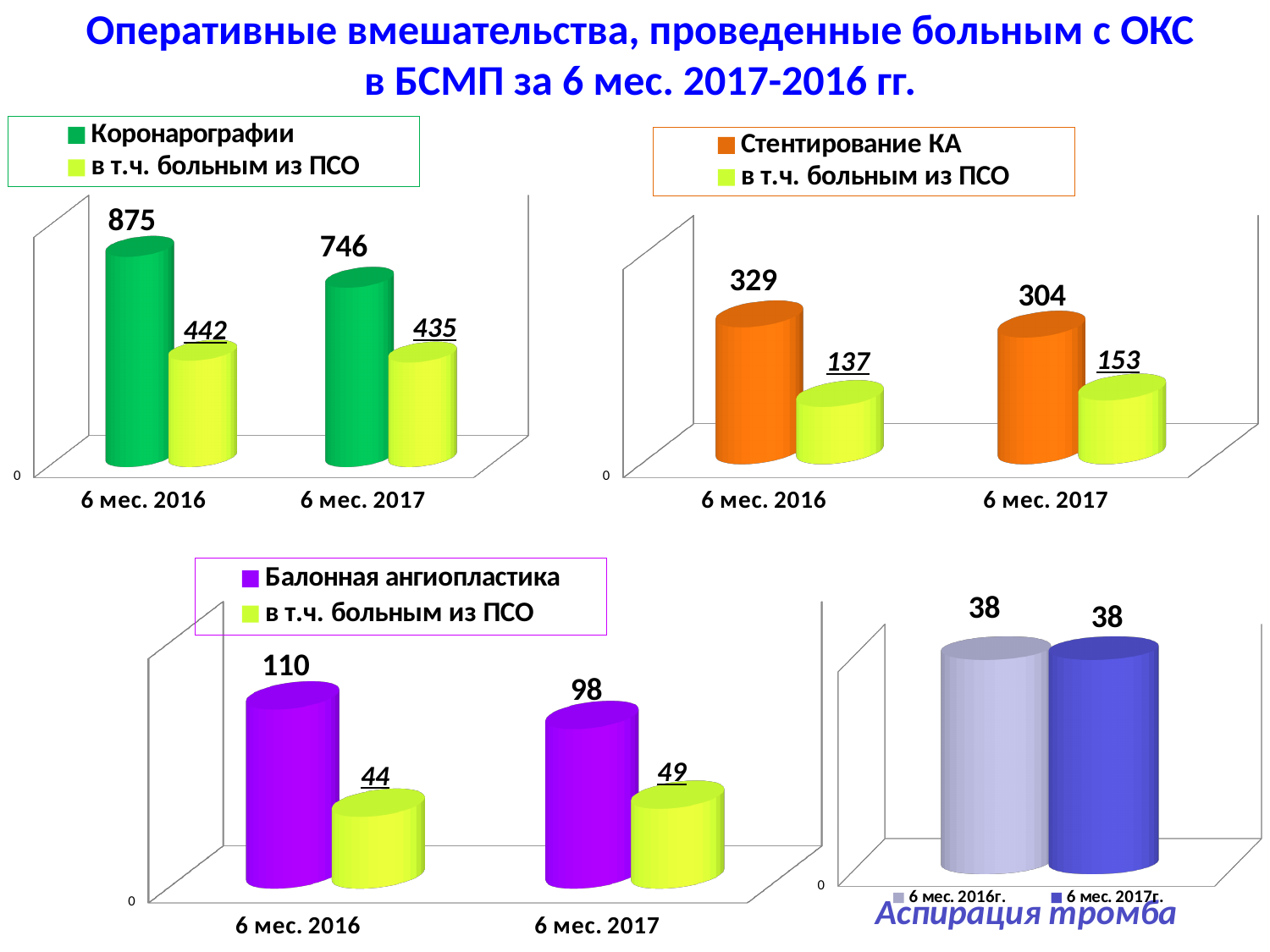
In the top-right chart (Стентирование КА), what is the difference between the в т.ч. больным из ПСО values for 6 мес. 2017 and 6 мес. 2016? 16 In the top-right chart (Стентирование КА), which period has the higher value for в т.ч. больным из ПСО, 6 мес. 2016 or 6 мес. 2017? 6 мес. 2017 In the bottom-right chart (Аспирация тромба), what is the value for 6 мес. 2017г.? 38 In the top-left chart (Коронарографии), what is the value for Коронарографии in 6 мес. 2016? 875 In the top-left chart (Коронарографии), what is the value for в т.ч. больным из ПСО in 6 мес. 2017? 435 What kind of chart is the bottom-right chart (Аспирация тромба)? bar chart In the bottom-left chart (Балонная ангиопластика), what is the value for Балонная ангиопластика in 6 мес. 2016? 110 In the bottom-left chart (Балонная ангиопластика), what is the value for в т.ч. больным из ПСО in 6 мес. 2017? 49 In the top-right chart (Стентирование КА), what is the value for Стентирование КА in 6 мес. 2017? 304 In the bottom-left chart (Балонная ангиопластика), does the Балонная ангиопластика value rise or fall from 6 мес. 2016 to 6 мес. 2017? fall How many series does the legend of the top-left chart (Коронарографии) list? 2 In the top-left chart (Коронарографии), what is the difference between the Коронарографии values for 6 мес. 2016 and 6 мес. 2017? 129